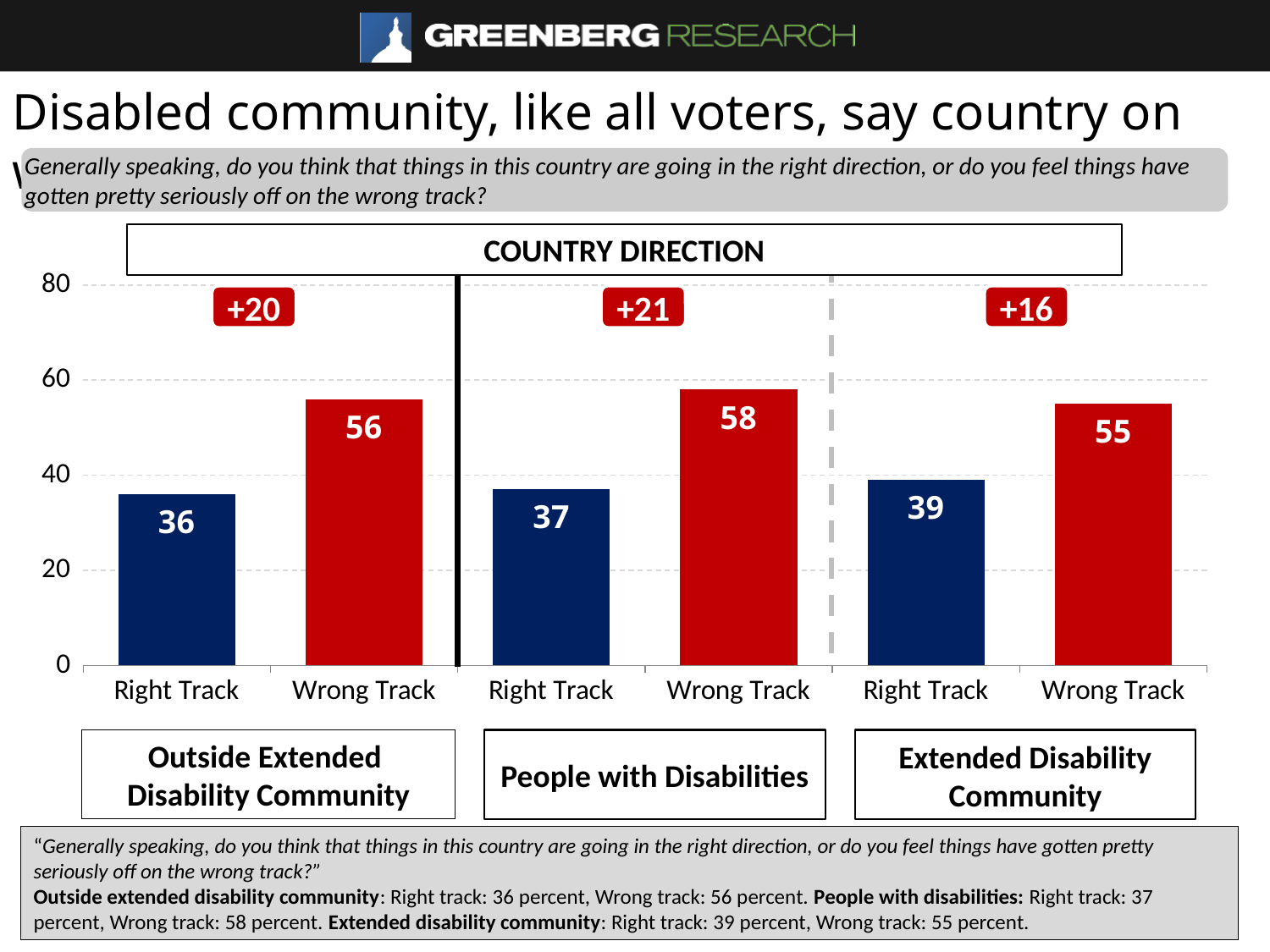
What is the Wrong Track value for People with Disabilities? 58 What is the Right Track value for the Extended Disability Community? 39 What is the difference between Wrong Track and Right Track for the Extended Disability Community? 16 What is the difference between Wrong Track and Right Track for the Outside Extended Disability Community group? 20 How many bars are plotted on the chart? 6 What is the Right Track value for the Outside Extended Disability Community group? 36 What is the title of the chart? COUNTRY DIRECTION Which group has the highest Wrong Track value? People with Disabilities Which is larger for People with Disabilities, Right Track or Wrong Track? Wrong Track What kind of chart is shown on the slide? Bar chart Which group has the lowest Right Track value? Outside Extended Disability Community Is the Wrong Track value for the Extended Disability Community greater or less than 40? greater